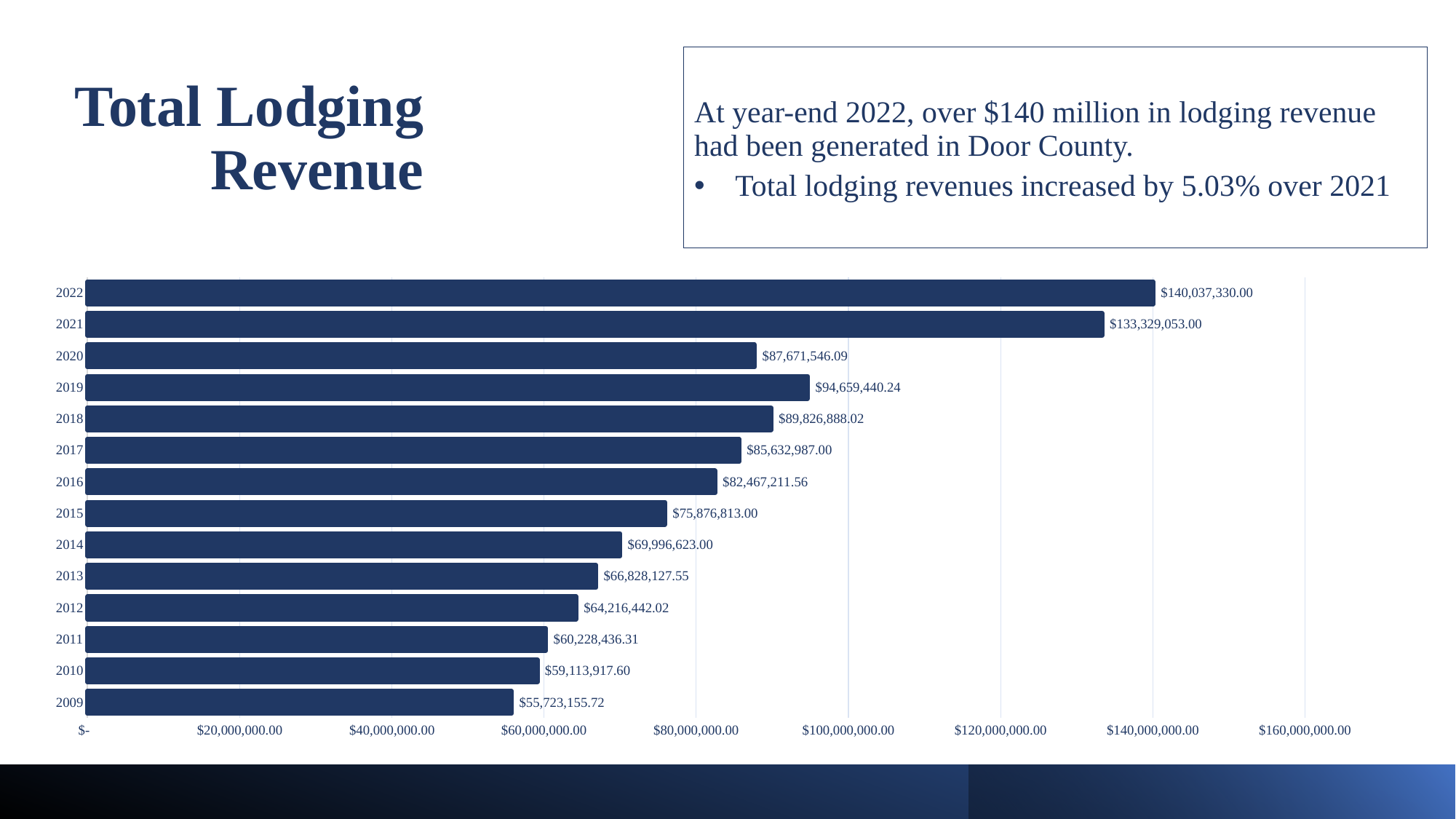
What is the difference between the lodging revenue for 2019 and 2020? $6,987,894.15 What is the total lodging revenue shown for 2019? $94,659,440.24 How many years are shown in the chart? 14 What is the total lodging revenue shown for 2009? $55,723,155.72 Overall, did total lodging revenue rise or fall from 2009 to 2022? rise Which year has the highest total lodging revenue? 2022 What is the total lodging revenue shown for 2022? $140,037,330.00 Which year has the lowest total lodging revenue? 2009 Which year had higher lodging revenue, 2018 or 2020? 2018 What is the difference between the lodging revenue for 2022 and 2021? $6,708,277.00 What kind of chart is used to show total lodging revenue? bar chart Is the lodging revenue for 2015 greater or less than $80,000,000.00? less